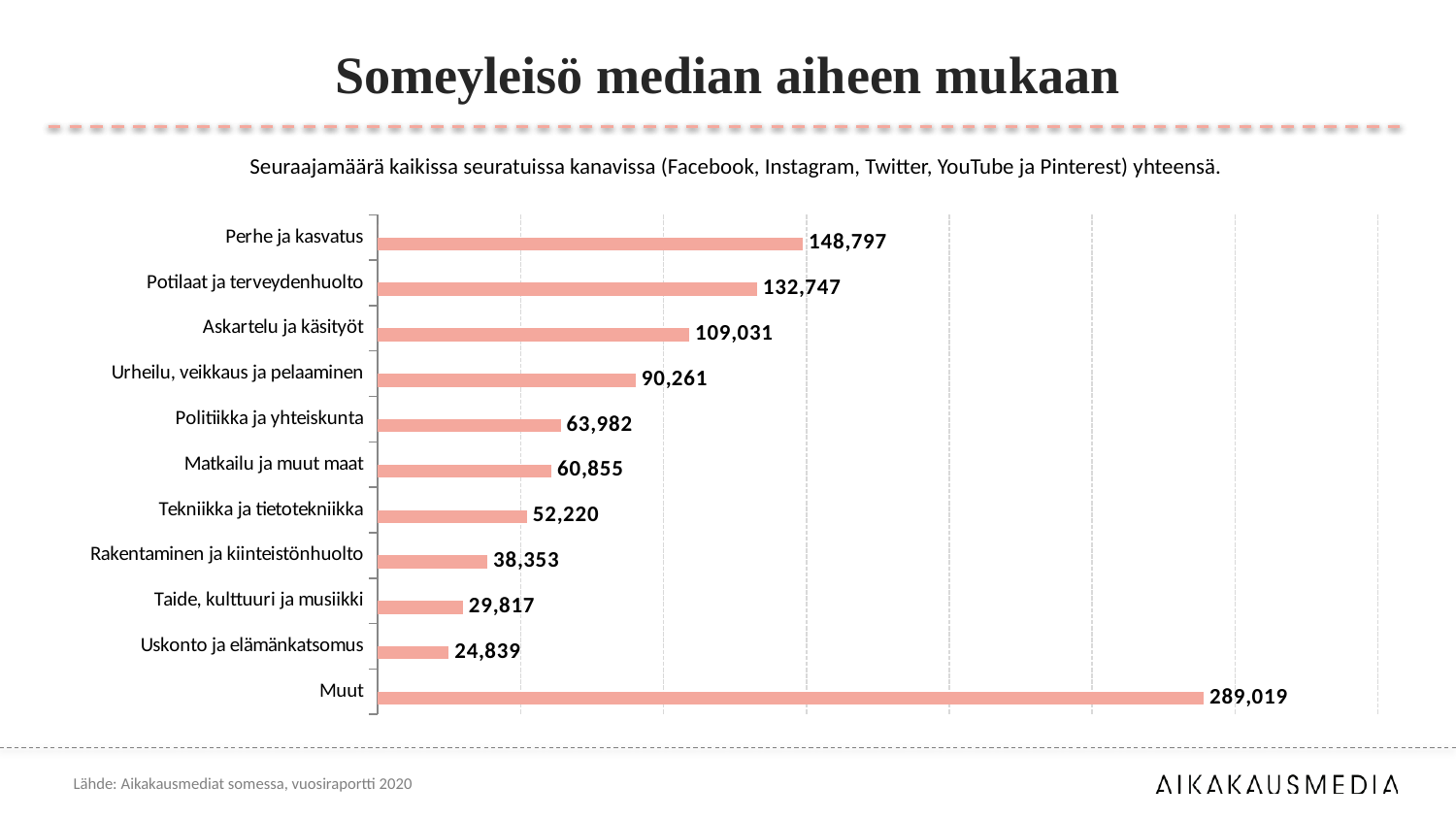
Which category has the lowest value? Uskonto ja elämänkatsomus What is the difference between the values for Perhe ja kasvatus and Potilaat ja terveydenhuolto? 16,050 What kind of chart is shown on the slide? Bar chart How many categories are shown in the chart? 11 What is the title of the slide? Someyleisö median aiheen mukaan What is the difference between the values for Muut and Perhe ja kasvatus? 140,222 What is the value for Tekniikka ja tietotekniikka? 52,220 What is the value for Uskonto ja elämänkatsomus? 24,839 What is the value for Perhe ja kasvatus? 148,797 What is the value for Muut? 289,019 Which is larger, the value for Askartelu ja käsityöt or the value for Urheilu, veikkaus ja pelaaminen? Askartelu ja käsityöt Which category has the highest value? Muut